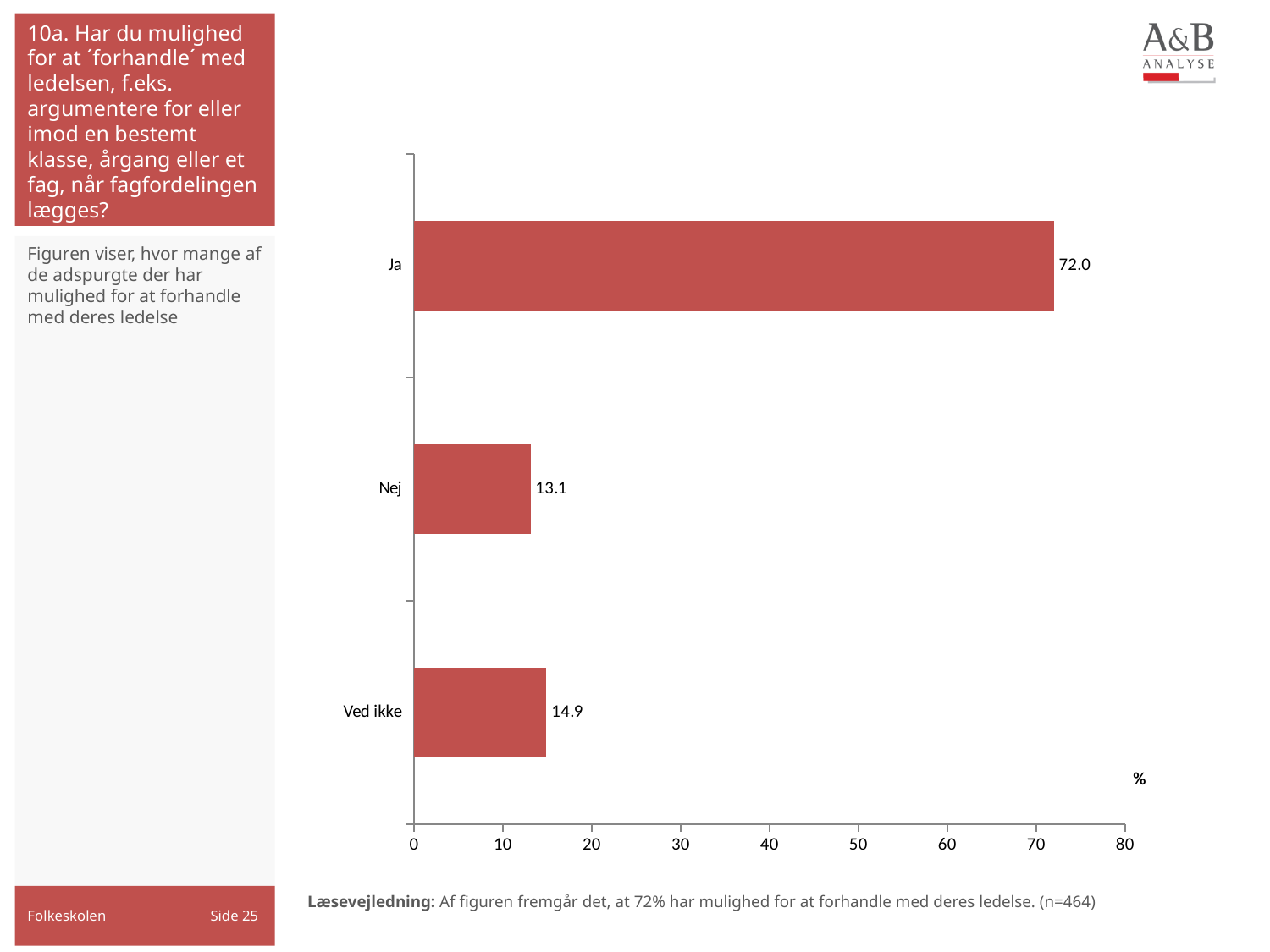
What unit is indicated on the horizontal axis of the chart? % What is the value for "Ja"? 72.0 What is the difference between the values for "Ved ikke" and "Nej"? 1.8 How many categories are shown in the chart? 3 Which category has the lowest value? Nej What is the value for "Nej"? 13.1 What kind of chart is shown on the slide? bar chart Is the value for "Ja" greater or less than 70? greater What is the value for "Ved ikke"? 14.9 Which category has the highest value? Ja Which is larger, the value for "Ja" or the value for "Ved ikke"? Ja What is the difference between the values for "Ja" and "Nej"? 58.9